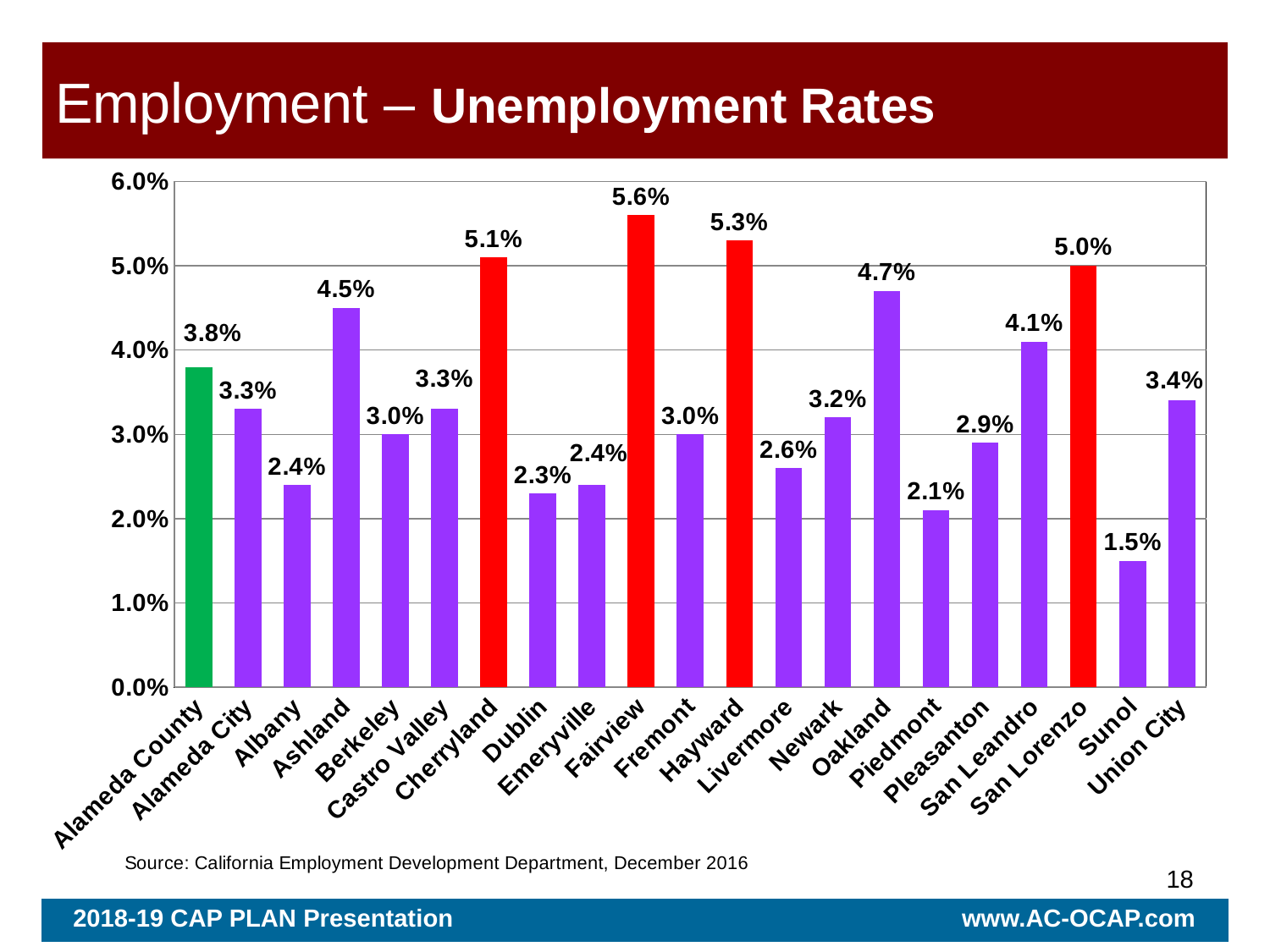
What is the difference in percentage points between the unemployment rates of Hayward and Oakland? 0.6 percentage points What is the unemployment rate shown for Pleasanton? 2.9% How many bars on the chart are coloured red? 4 Which has a higher unemployment rate, Union City or Livermore? Union City Which area has the highest unemployment rate on the chart? Fairview What is the unemployment rate shown for Oakland? 4.7% Which area has the lowest unemployment rate on the chart? Sunol What is the unemployment rate shown for Alameda County? 3.8% What is the difference in percentage points between the unemployment rates of Fairview and Sunol? 4.1 percentage points How many areas (bars) are shown on the chart? 21 Which has a higher unemployment rate, Cherryland or San Leandro? Cherryland What kind of chart is used on this slide? Bar chart